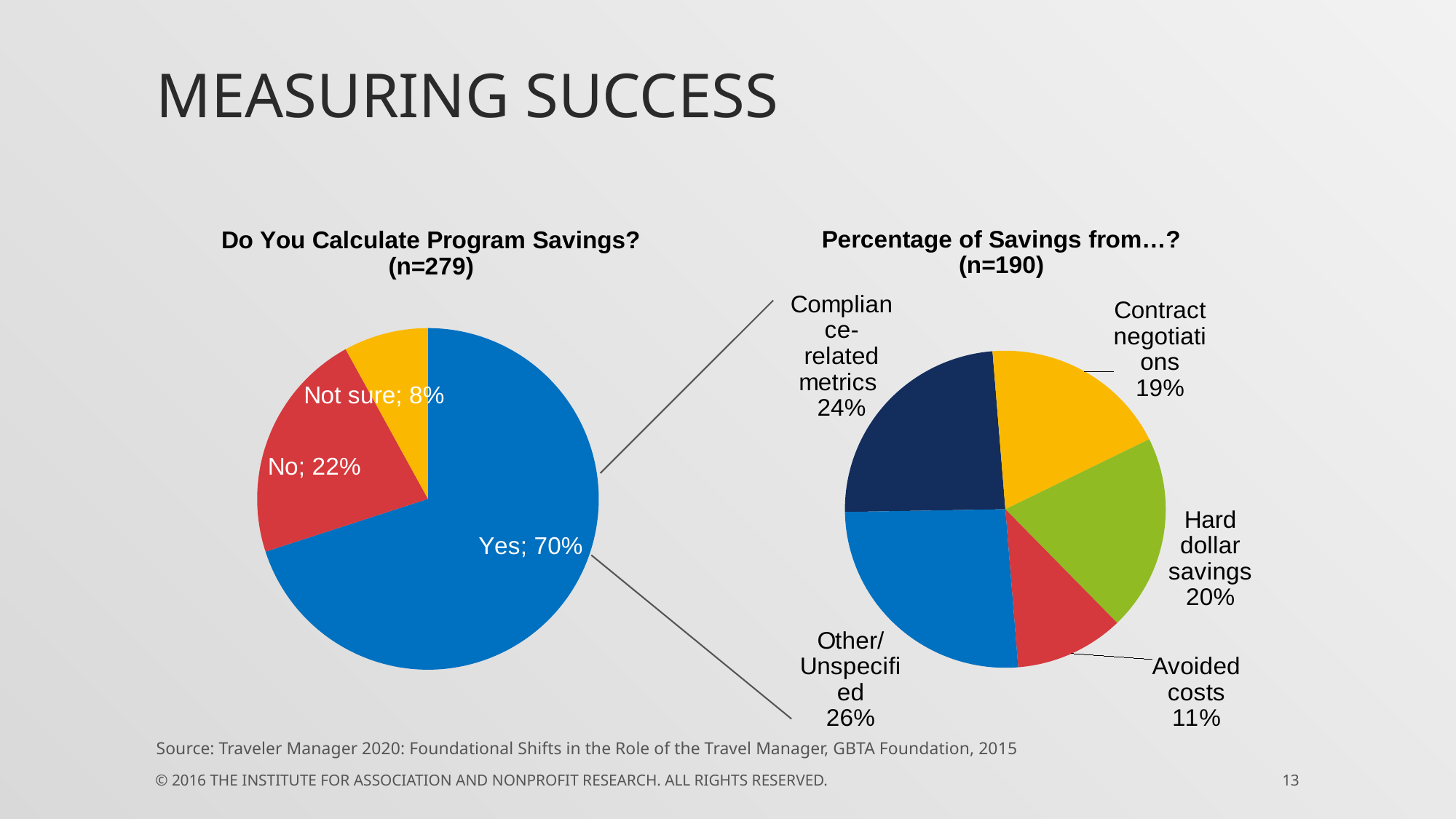
In the 'Do You Calculate Program Savings?' chart, what percentage answered Yes? 70% What type of chart is used for 'Percentage of Savings from…?' Pie chart In the 'Do You Calculate Program Savings?' chart, which response has the smallest share? Not sure In the 'Percentage of Savings from…?' chart, which category has the largest share? Other/Unspecified How many slices does the 'Do You Calculate Program Savings?' pie chart have? 3 In the 'Do You Calculate Program Savings?' chart, what is the difference between the Yes and No shares? 48 percentage points In the 'Do You Calculate Program Savings?' chart, what percentage answered No? 22% In the 'Percentage of Savings from…?' chart, what is the share for Hard dollar savings? 20% In the 'Percentage of Savings from…?' chart, which category has the smallest share? Avoided costs How many categories are shown in the 'Percentage of Savings from…?' pie chart? 5 What is the sample size (n) shown in the title of the 'Percentage of Savings from…?' chart? n=190 In the 'Percentage of Savings from…?' chart, which is larger: Compliance-related metrics or Contract negotiations? Compliance-related metrics